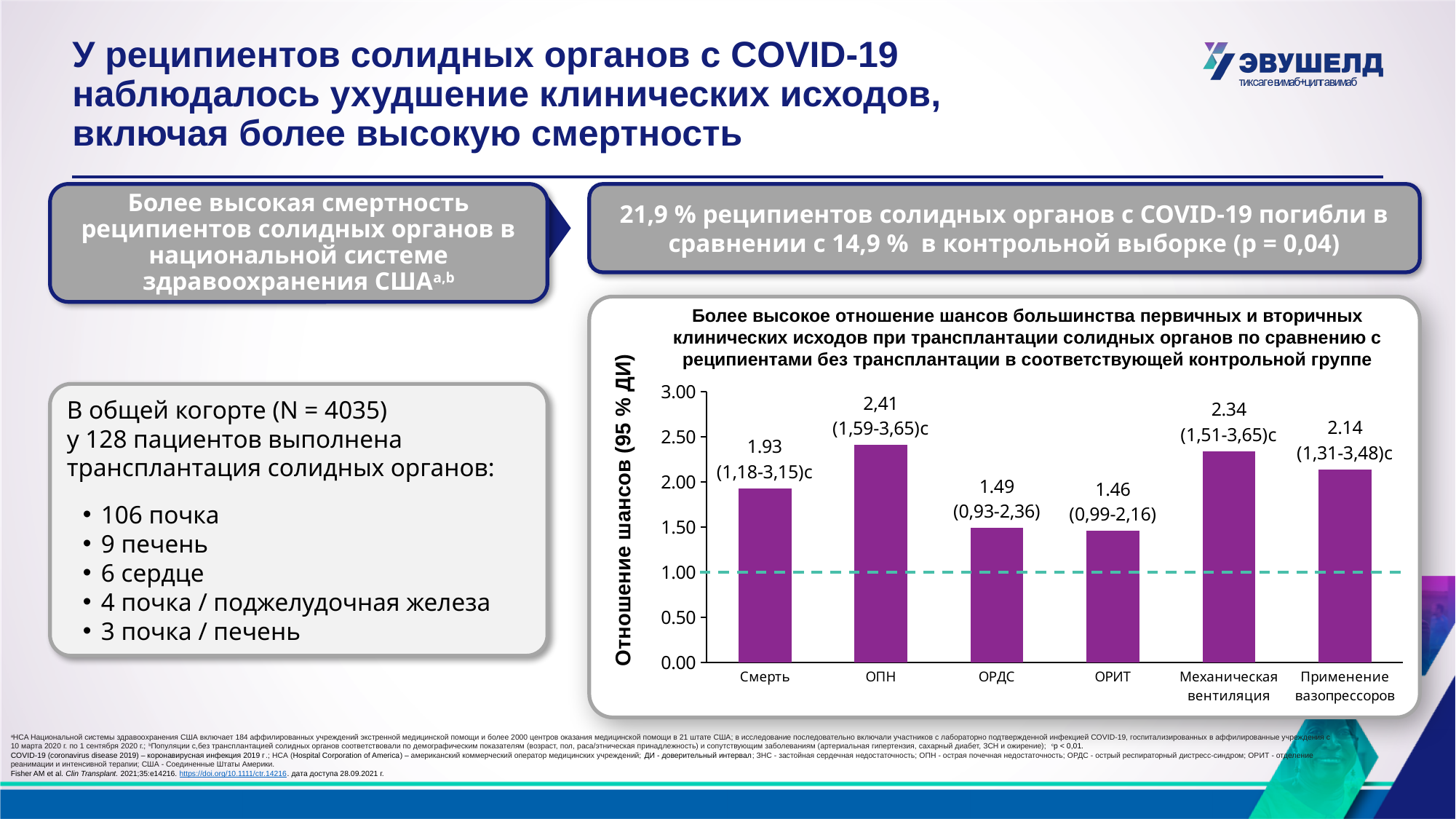
Сколько категорий (клинических исходов) показано на диаграмме? 6 Для какой категории отношение шансов наибольшее? ОПН Какое отношение шансов указано для категории «ОПН»? 2,41 Какое отношение шансов указано для категории «Механическая вентиляция»? 2.34 Для какой категории отношение шансов наименьшее? ОРИТ На сколько отношение шансов для «ОПН» больше, чем для «Смерть»? 0.48 Какого типа эта диаграмма? столбчатая (bar chart) Отношение шансов для «ОРДС» больше или меньше 2.00? меньше Что больше: отношение шансов для «Механическая вентиляция» или для «Применение вазопрессоров»? Механическая вентиляция Как подписана вертикальная ось диаграммы? Отношение шансов (95 % ДИ) Какое отношение шансов указано для категории «Смерть»? 1.93 Какое отношение шансов указано для категории «Применение вазопрессоров»? 2.14